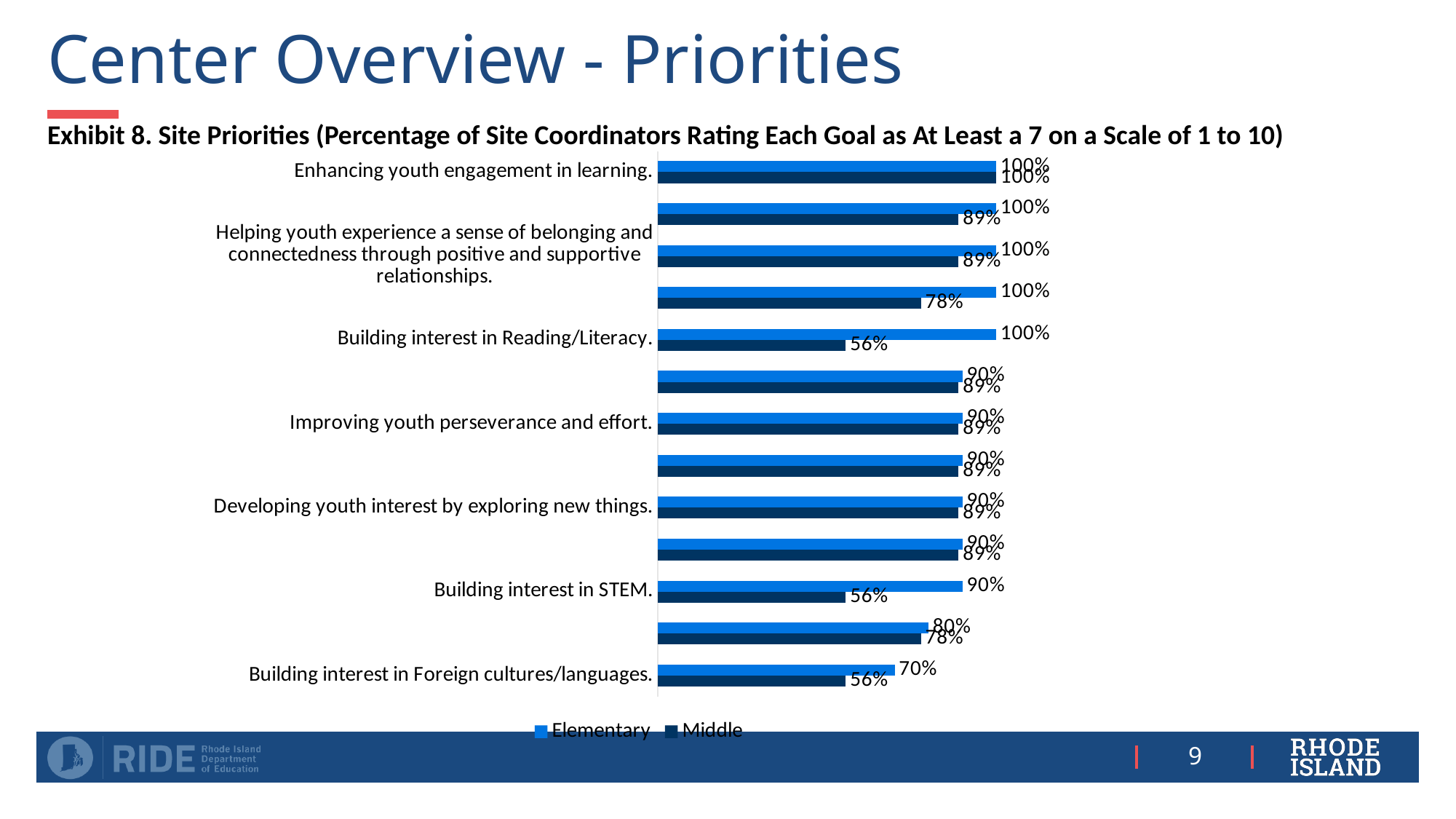
For "Building interest in Reading/Literacy.", which series has the larger value, Elementary or Middle? Elementary What is the Middle value for "Improving youth perseverance and effort."? 89% Which labeled goal has the lowest Elementary value? Building interest in Foreign cultures/languages. What kind of chart is shown on the slide? Bar chart What is the difference between the Elementary and Middle values for "Building interest in Reading/Literacy."? 44 percentage points What is the Elementary value for "Building interest in Foreign cultures/languages."? 70% What is the difference between the Elementary and Middle values for "Building interest in STEM."? 34 percentage points Which series is shown in the darker blue colour? Middle What is the Middle value for "Enhancing youth engagement in learning."? 100% How many series does the legend list? 2 What is the Elementary value for "Building interest in STEM."? 90% What is the Middle value for "Building interest in Reading/Literacy."? 56%